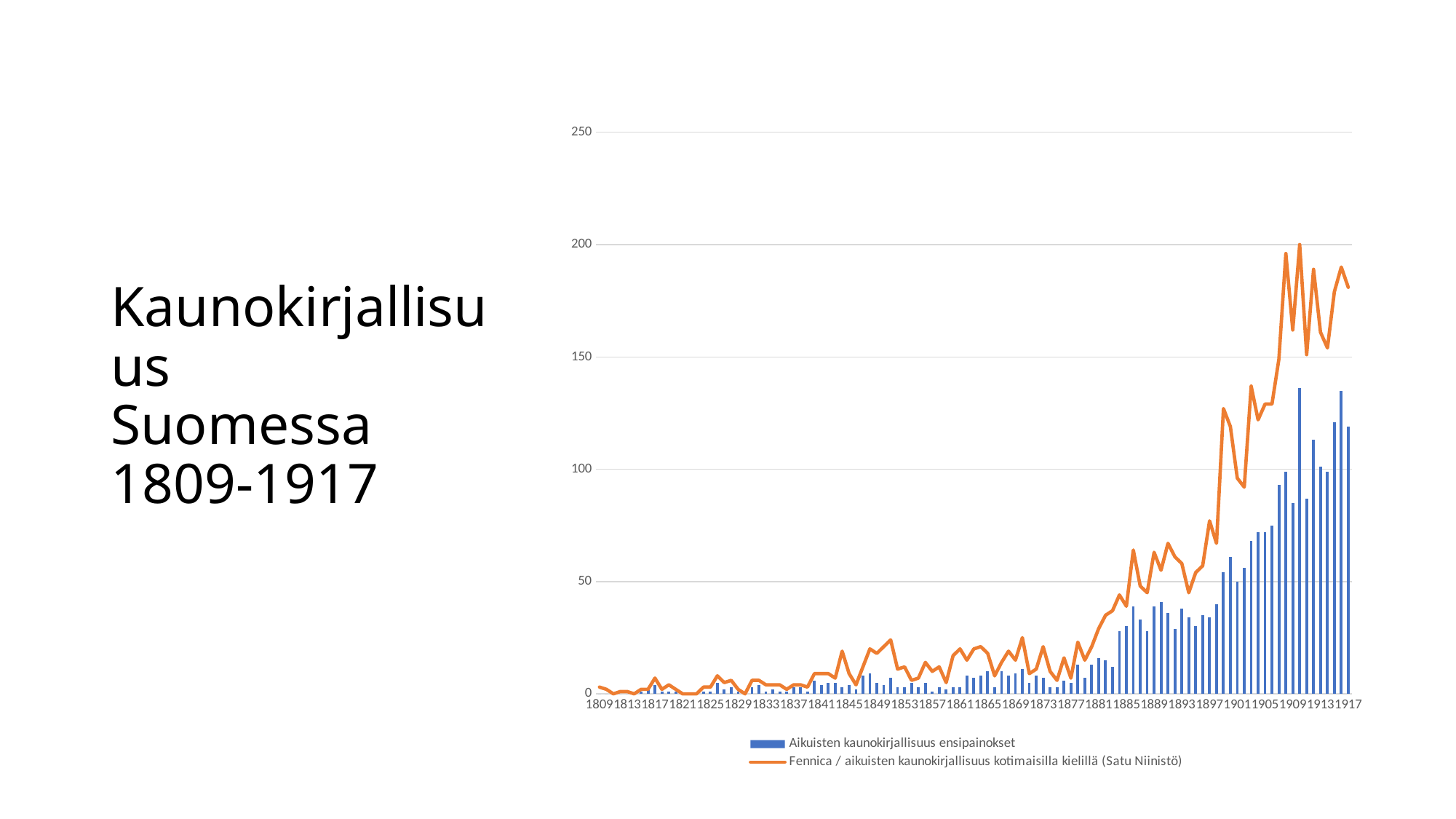
Is the value of the blue bar (Aikuisten kaunokirjallisuus ensipainokset) at 1809 greater or less than 50? less Is the value of the blue bar (Aikuisten kaunokirjallisuus ensipainokset) at 1905 greater or less than 50? greater At 1917, which is larger: the orange line (Fennica) or the blue bar (Aikuisten kaunokirjallisuus ensipainokset)? The orange line (Fennica) Do the values of the orange line generally rise or fall from 1809 to 1917? Rise Is the value of the orange line (Fennica) at 1881 greater or less than 50? less How many series does the legend list? 2 Which series is drawn as blue bars? Aikuisten kaunokirjallisuus ensipainokset What kind of chart is shown on the slide? A combined bar and line chart Which series is drawn as an orange line? Fennica / aikuisten kaunokirjallisuus kotimaisilla kielillä (Satu Niinistö)